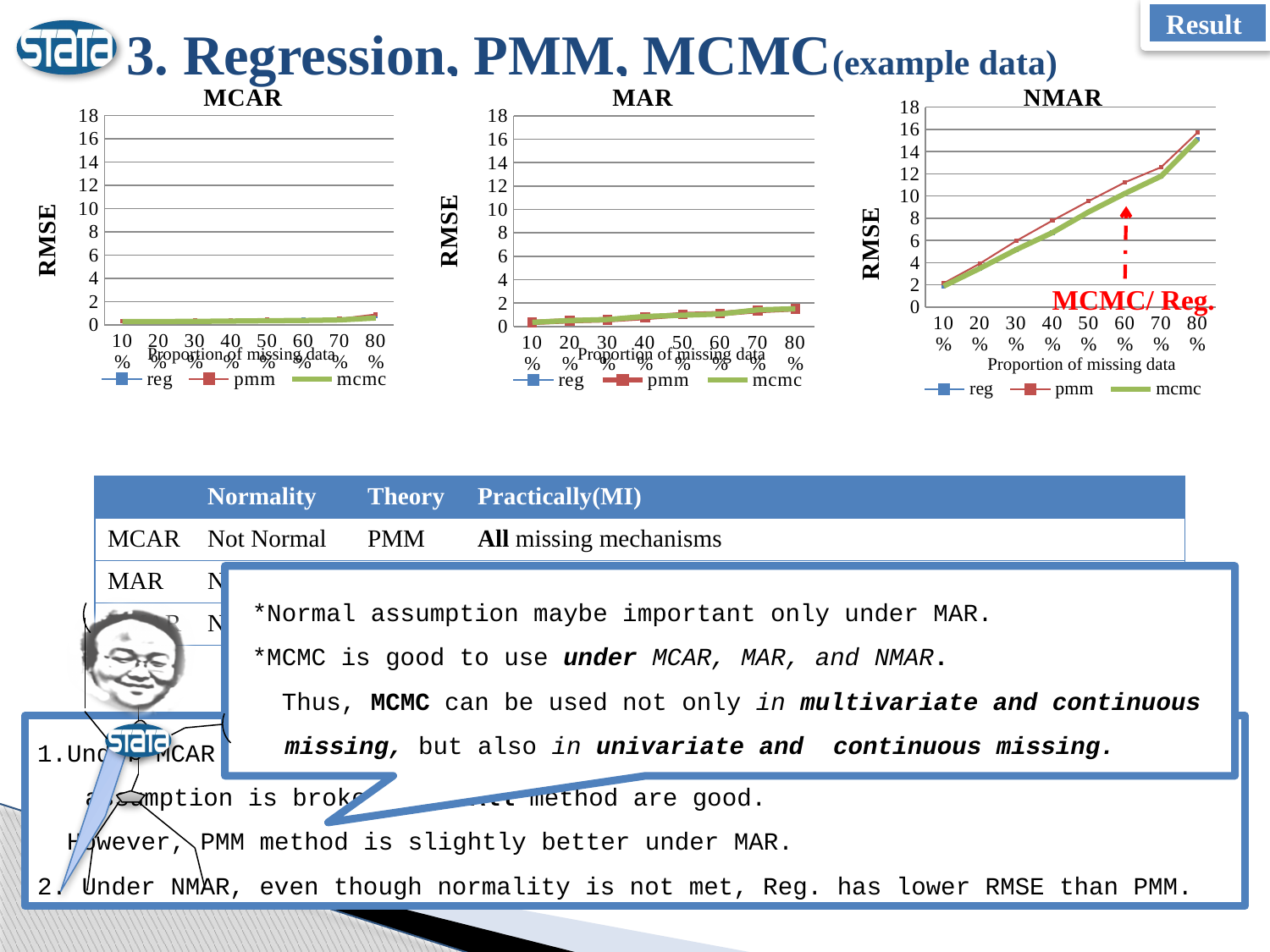
How many proportion-of-missing-data points are plotted along the x axis of the MAR chart? 8 What is the label on the y axis of the MAR chart? RMSE At 80% missing data, which chart shows the higher RMSE for mcmc: the MCAR chart or the NMAR chart? NMAR In the NMAR chart, is the value for reg at 10% greater or less than 4? less What type of chart is the MCAR chart? line chart What are the three legend entries in the MCAR chart? reg, pmm, mcmc In the NMAR chart, is the value for pmm at 80% greater or less than 14? greater In the NMAR chart, do the RMSE values rise or fall as the proportion of missing data increases? rise In the MCAR chart, is the value for mcmc at 80% greater or less than 2? less In the NMAR chart, which is larger: the pmm value at 10% or the pmm value at 80%? 80% How many series does the legend of the NMAR chart list? 3